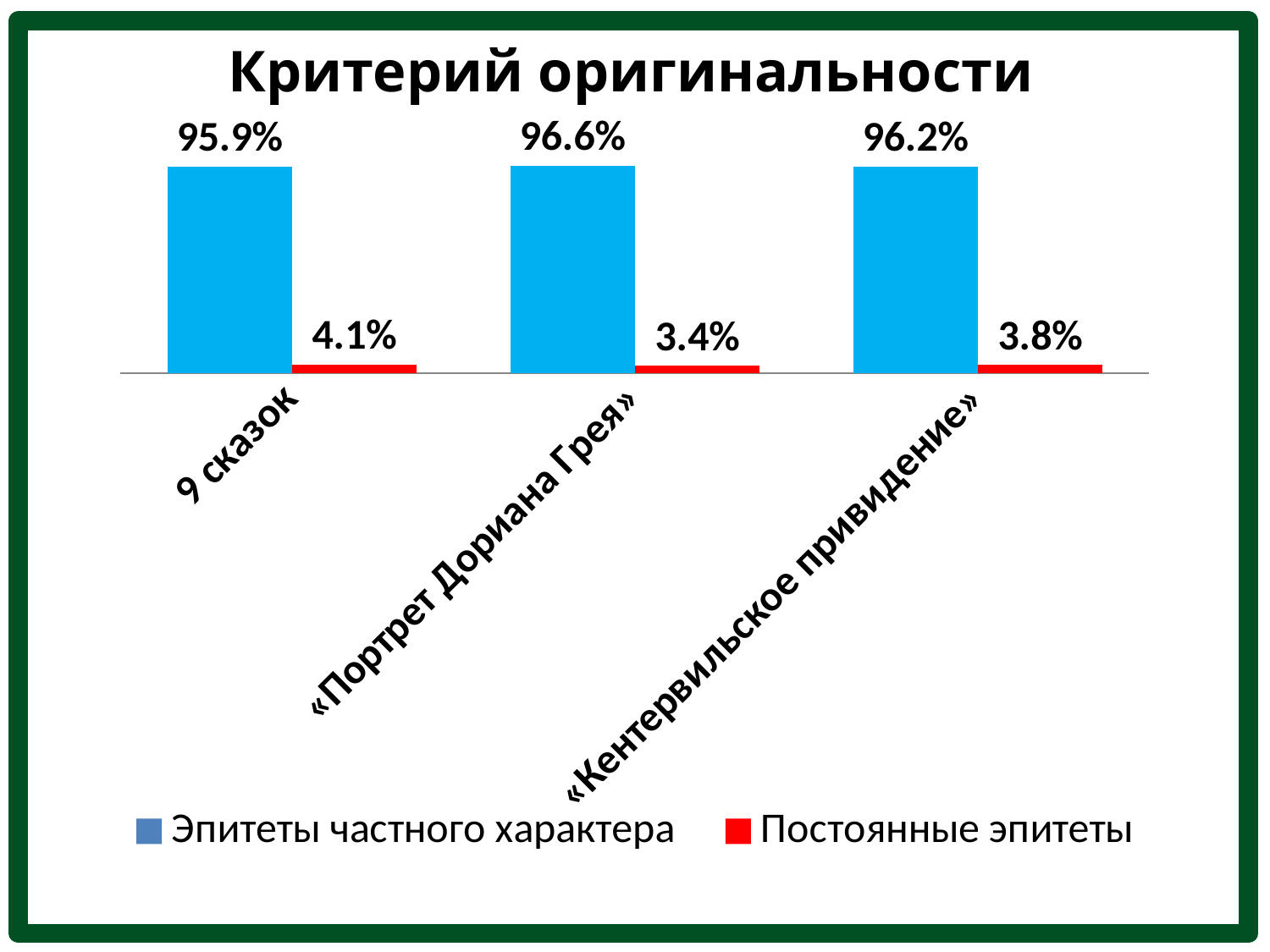
What is the difference between «Эпитеты частного характера» and «Постоянные эпитеты» for «Кентервильское привидение»? 92.4% Which category has the lowest value for «Постоянные эпитеты»? «Портрет Дориана Грея» What is the value of «Эпитеты частного характера» for «Кентервильское привидение»? 96.2% Which category has the highest value for «Эпитеты частного характера»? «Портрет Дориана Грея» What is the value of «Постоянные эпитеты» for «9 сказок»? 4.1% What kind of chart is shown on the slide? Bar chart How many categories are shown on the x axis? 3 What is the value of «Эпитеты частного характера» for «9 сказок»? 95.9% What is the value of «Постоянные эпитеты» for «Портрет Дориана Грея»? 3.4% What is the title of the chart? Критерий оригинальности How many series does the legend list? 2 Which is larger: «Постоянные эпитеты» for «9 сказок» or for «Кентервильское привидение»? «9 сказок»